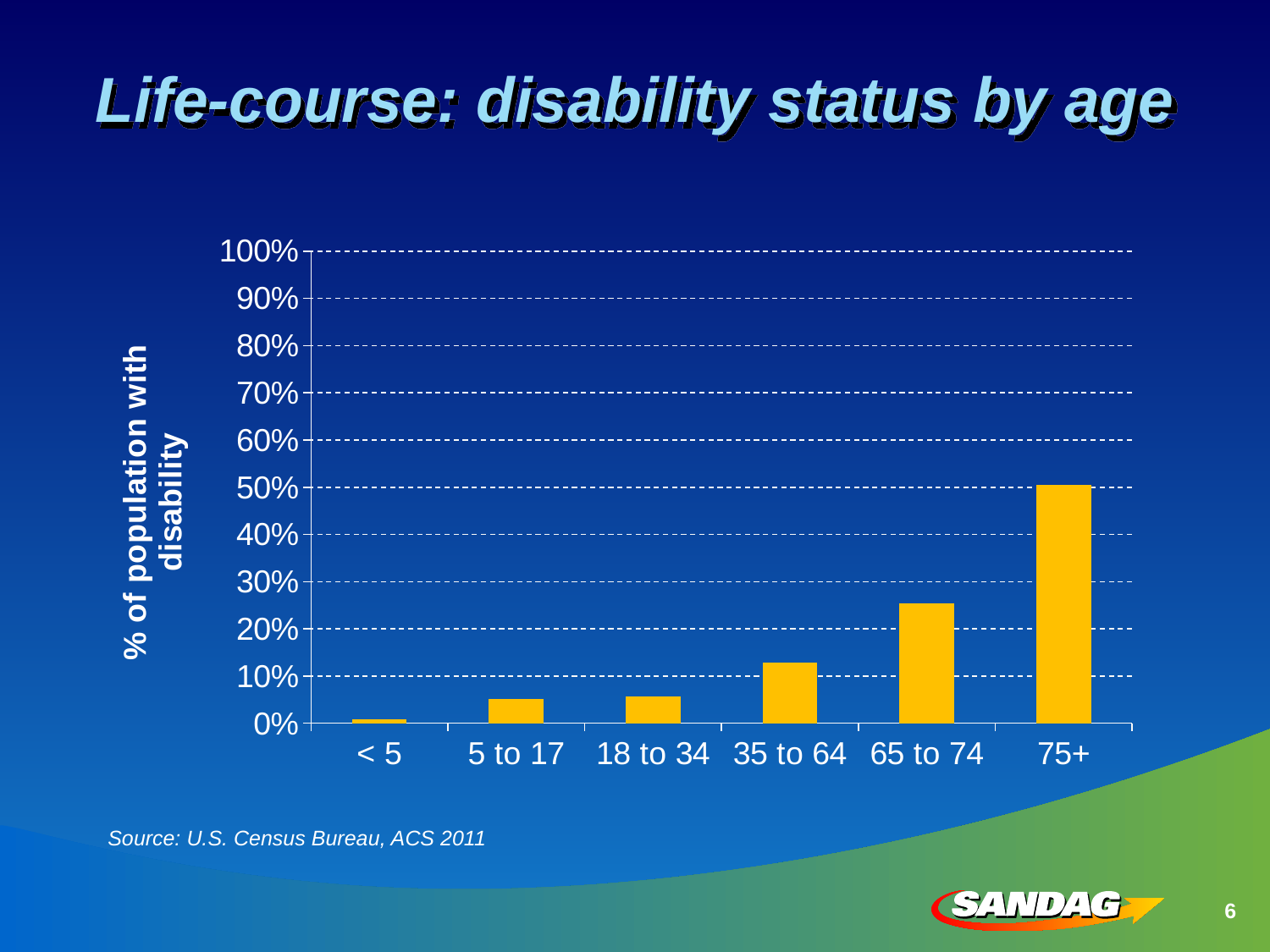
Is the value for the 65 to 74 age group greater or less than 20%? greater Which age group has the highest percentage of population with a disability? 75+ Which age group has the lowest percentage of population with a disability? < 5 Is the value for the 35 to 64 age group greater or less than 10%? greater What kind of chart is shown on the slide? bar chart How many age categories are shown on the x axis? 6 Is the value for the 75+ age group greater or less than 40%? greater What is the label on the y axis of the chart? % of population with disability Which is larger, the value for 65 to 74 or the value for 35 to 64? 65 to 74 Do the values generally rise or fall as age increases along the x axis? rise